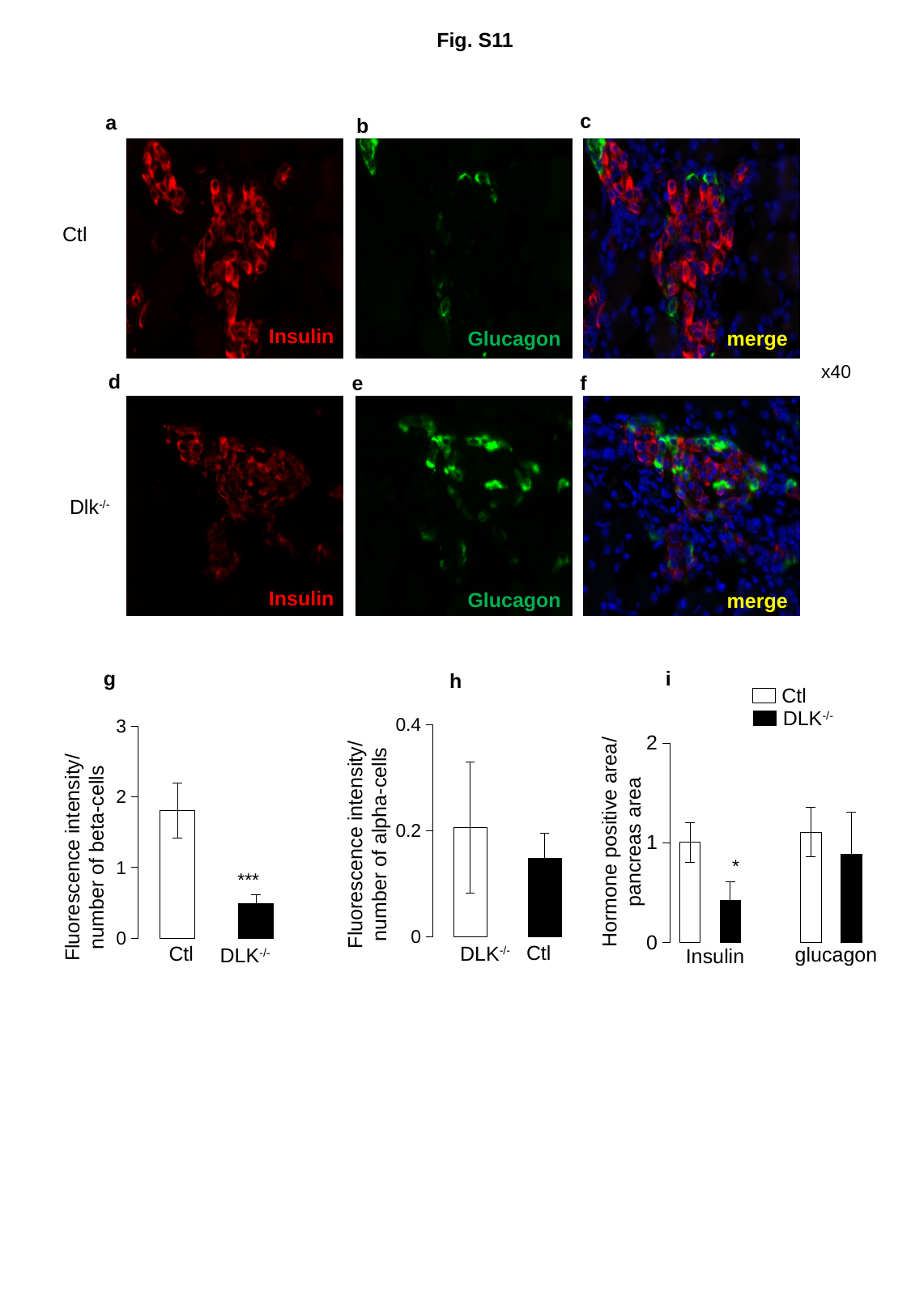
In chart i, for Insulin, which series has the larger bar, Ctl or DLK-/-? Ctl What kind of chart is chart g? bar chart In chart g, how many bars are plotted? 2 In chart i, is the DLK-/- value for Insulin greater or less than 1? less In chart i, how many categories are shown on the x axis? 2 In chart h, is the value for Ctl greater or less than 0.2? less In chart h, which category has the higher bar, DLK-/- or Ctl? DLK-/- In chart i, how many series does the legend list? 2 In chart g, which category has the higher bar, Ctl or DLK-/-? Ctl In chart g, is the value for Ctl greater or less than 1? greater In chart i, which series is shown with black bars? DLK-/-